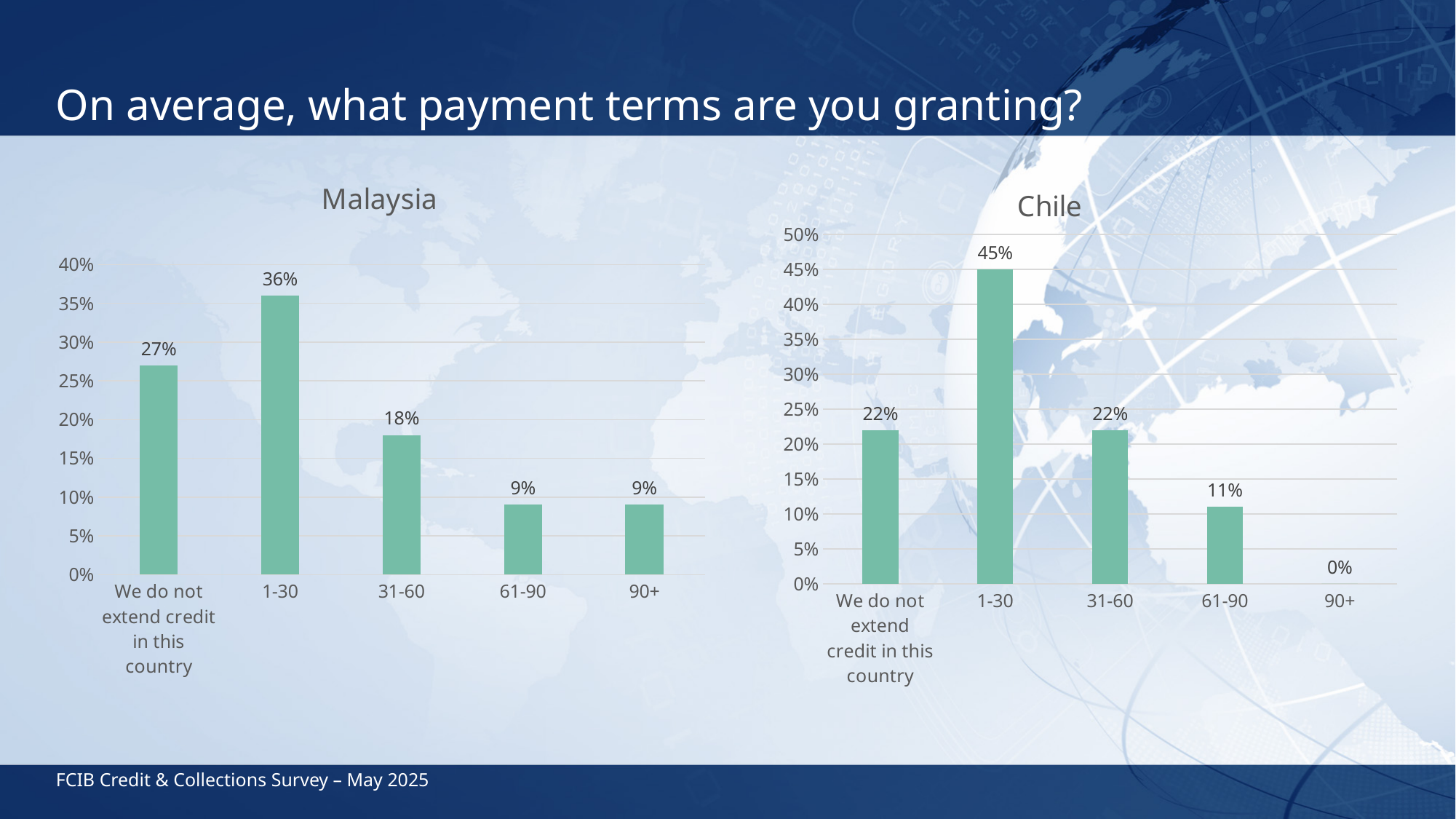
In the Chile chart, which category has the highest value? 1-30 In the Malaysia chart, what is the difference between the values for 1-30 and 31-60? 18% How many categories are shown in the Chile chart? 5 What kind of chart is the Malaysia chart? Bar chart In the Malaysia chart, what is the value for 'We do not extend credit in this country'? 27% In the Malaysia chart, which category has the highest value? 1-30 In the Chile chart, what is the difference between the values for 1-30 and 61-90? 34% Which is larger: the value for 1-30 in the Malaysia chart or the value for 1-30 in the Chile chart? Chile In the Malaysia chart, what is the value for 1-30? 36% In the Chile chart, what is the value for 90+? 0% In the Chile chart, what is the value for 61-90? 11% In the Chile chart, which category has the lowest value? 90+